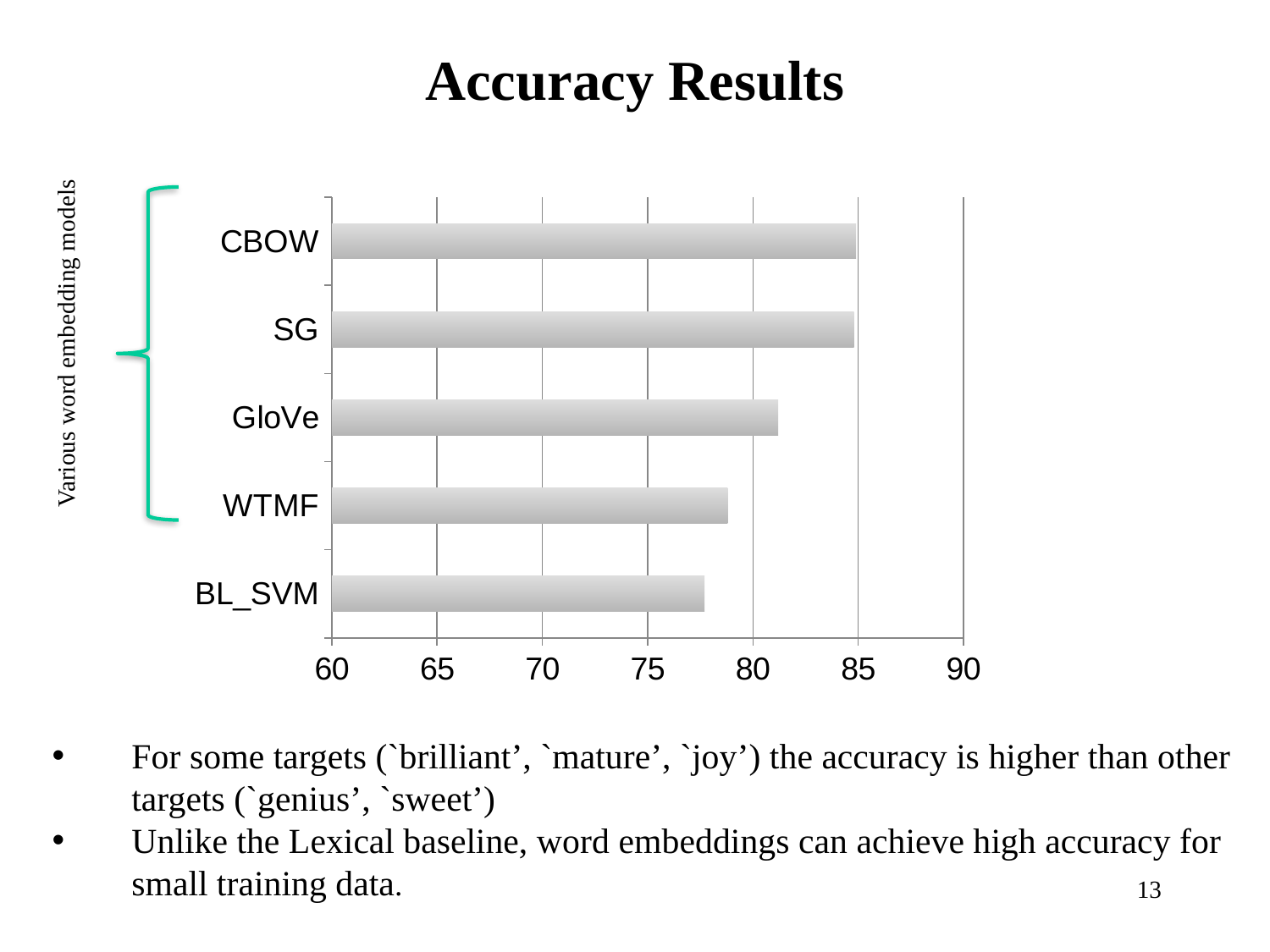
Is the value for BL_SVM greater or less than 80? less Is the value for CBOW greater or less than 80? greater Which is larger, the value for GloVe or the value for WTMF? GloVe Is the value for GloVe greater or less than 80? greater What is the title of the chart on the slide? Accuracy Results Which is larger, the value for SG or the value for BL_SVM? SG Which category has the lowest value in the chart? BL_SVM How many categories (models) are plotted in the chart? 5 Which is larger, the value for CBOW or the value for GloVe? CBOW What kind of chart is shown on the slide? bar chart